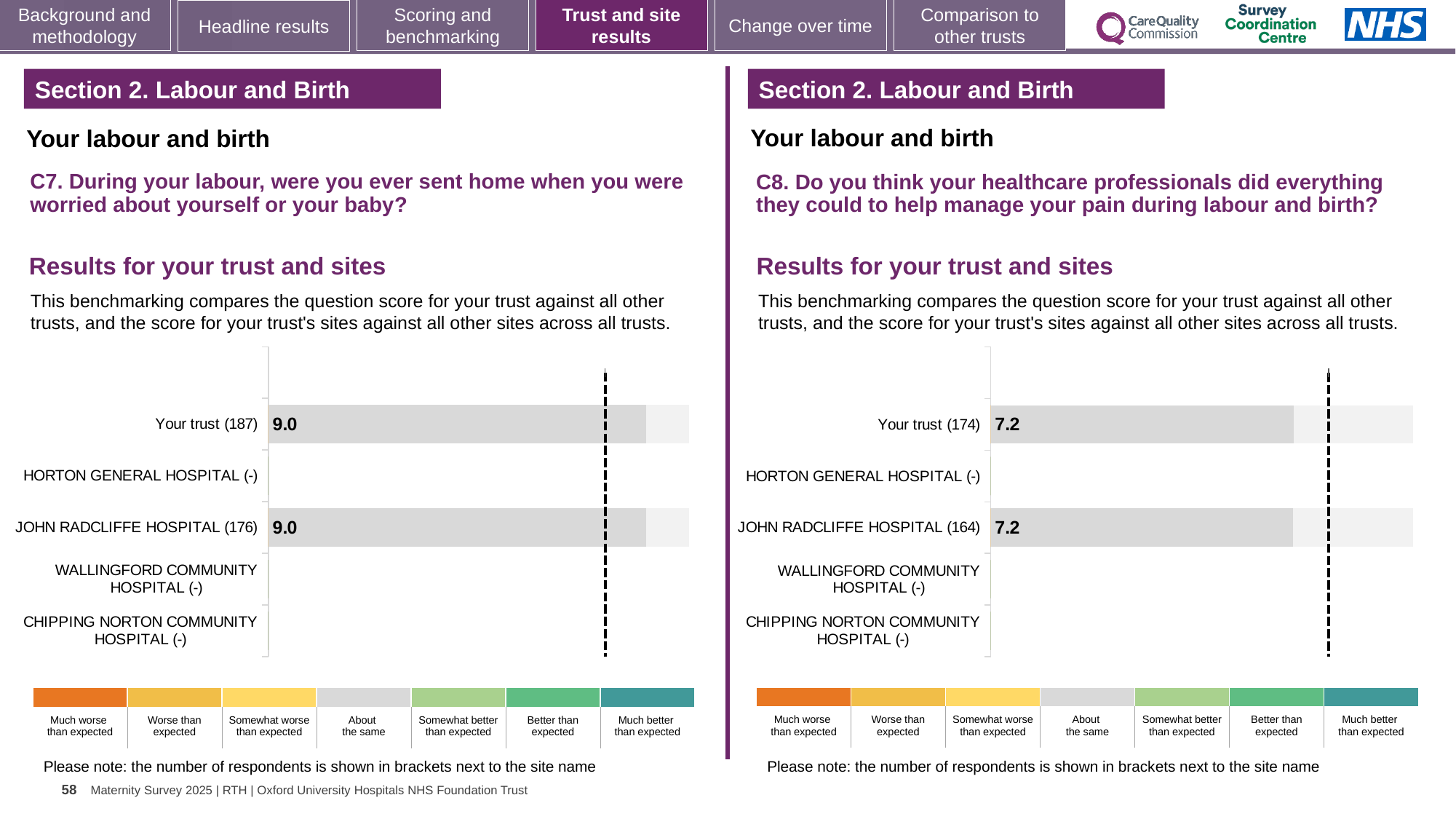
How many categories does the colour legend below the left chart (C7) list? 7 In the left chart (C7), what is the score for JOHN RADCLIFFE HOSPITAL? 9.0 In the right chart (C8), what is the score for JOHN RADCLIFFE HOSPITAL? 7.2 How many site/trust categories are listed on the left chart (C7)? 5 In the right chart (C8), how many respondents are shown in brackets for JOHN RADCLIFFE HOSPITAL? 164 In the right chart (C8), what is the score for Your trust? 7.2 In the right chart (C8), which site has no score shown and is marked with (-) directly below Your trust? HORTON GENERAL HOSPITAL What is the difference between the Your trust score in the left chart (C7) and the Your trust score in the right chart (C8)? 1.8 What kind of chart is used on the right (C8) to show the results for your trust and sites? Bar chart Is the score for Your trust in the left chart (C7) larger or smaller than the score for Your trust in the right chart (C8)? Larger In the left chart (C7), what is the score for Your trust? 9.0 In the left chart (C7), how many respondents are shown in brackets for Your trust? 187